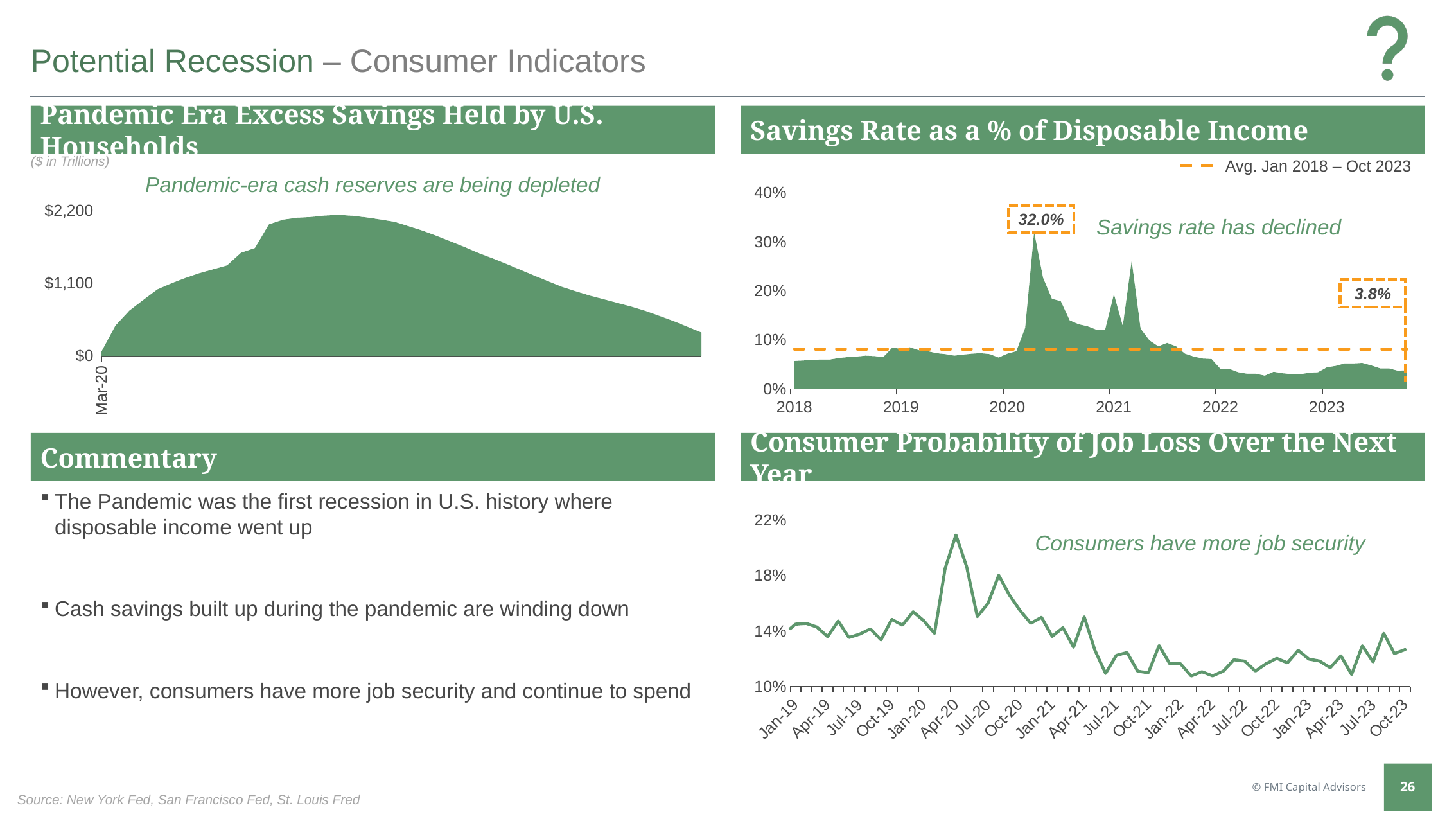
In the 'Pandemic Era Excess Savings Held by U.S. Households' chart, is the peak value greater or less than $1,100? greater What kind of chart is 'Consumer Probability of Job Loss Over the Next Year'? Line chart In the 'Pandemic Era Excess Savings Held by U.S. Households' chart, do values rise or fall after the peak toward the end of the series? fall In what units are the values in the 'Pandemic Era Excess Savings Held by U.S. Households' chart expressed? $ in Trillions In the 'Savings Rate as a % of Disposable Income' chart, what is the labeled most recent savings rate at the end of the series? 3.8% In the 'Savings Rate as a % of Disposable Income' chart, is the dashed average line (Avg. Jan 2018 – Oct 2023) greater or less than 10%? less In the 'Consumer Probability of Job Loss Over the Next Year' chart, is the value at Oct-23 greater or less than 14%? less In the 'Savings Rate as a % of Disposable Income' chart, what is the labeled peak savings rate in 2020? 32.0% What kind of chart is 'Savings Rate as a % of Disposable Income'? Area chart In the 'Savings Rate as a % of Disposable Income' chart, what is the difference between the labeled 2020 peak and the labeled latest value? 28.2 percentage points In the 'Savings Rate as a % of Disposable Income' chart, what does the orange dashed line represent? Avg. Jan 2018 – Oct 2023